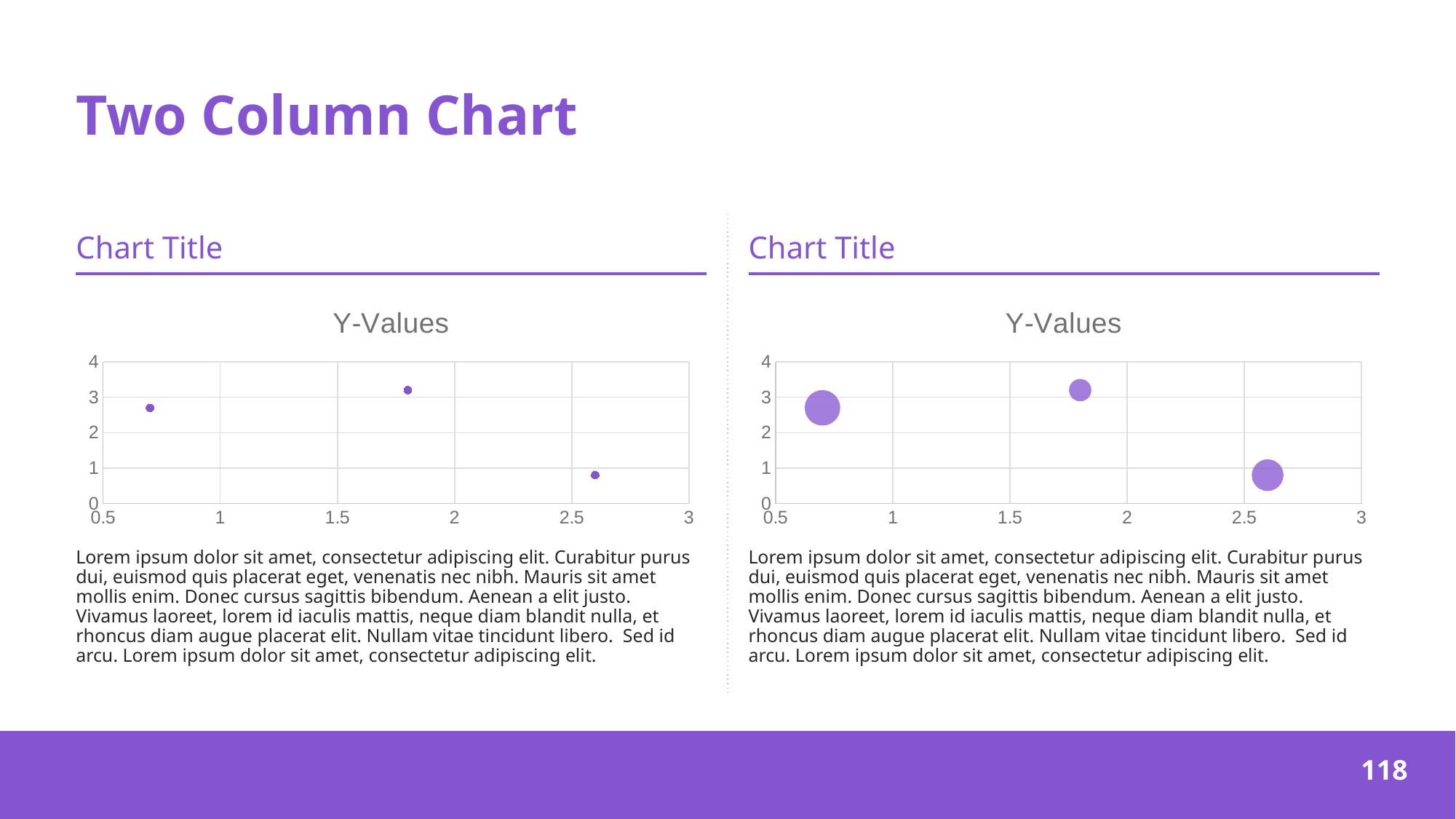
What is the title shown above the plot area of the left chart? Y-Values How many data points are plotted on the left chart? 3 What is the highest value shown on the y-axis of the right chart? 4 On the right chart, which bubble has the lowest y-value: the one nearest x = 0.5, x = 2, or x = 2.5? the one nearest x = 2.5 What kind of chart is the left chart? scatter chart On the right chart, is the y-value of the bubble nearest x = 0.5 greater or less than 2? greater On the left chart, is the y-value of the point nearest x = 2 greater or less than 3? greater What kind of chart is the right chart? bubble chart How many bubbles are plotted on the right chart? 3 On the left chart, which point has the highest y-value: the one nearest x = 0.5, x = 2, or x = 2.5? the one nearest x = 2 On the right chart, which bubble is larger: the one nearest x = 0.5 or the one nearest x = 2? the one nearest x = 0.5 On the left chart, is the y-value of the point nearest x = 2.5 greater or less than 1? less